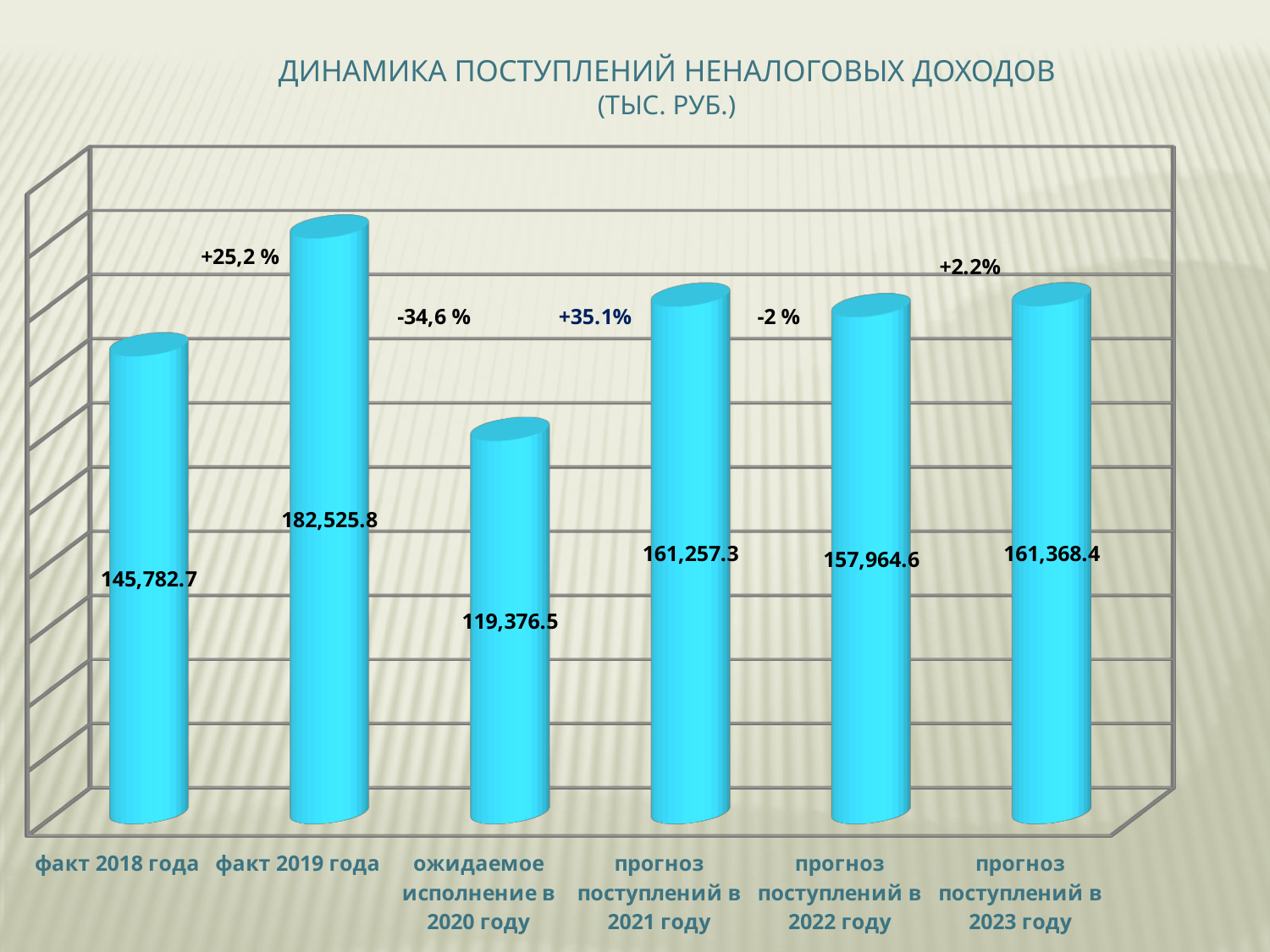
What type of chart is shown on the slide? bar chart Which is larger: the value for "факт 2018 года" or for "прогноз поступлений в 2022 году"? прогноз поступлений в 2022 году What is the value for "прогноз поступлений в 2022 году"? 157,964.6 Which category has the highest value? факт 2019 года What percentage change is annotated above the bar for "ожидаемое исполнение в 2020 году"? -34,6 % What is the title of the chart? ДИНАМИКА ПОСТУПЛЕНИЙ НЕНАЛОГОВЫХ ДОХОДОВ (ТЫС. РУБ.) How many categories are plotted in the chart? 6 What is the value for "факт 2018 года"? 145,782.7 What is the value for "ожидаемое исполнение в 2020 году"? 119,376.5 What is the difference between the values for "факт 2019 года" and "факт 2018 года"? 36,743.1 Which category has the lowest value? ожидаемое исполнение в 2020 году What is the value for "факт 2019 года"? 182,525.8